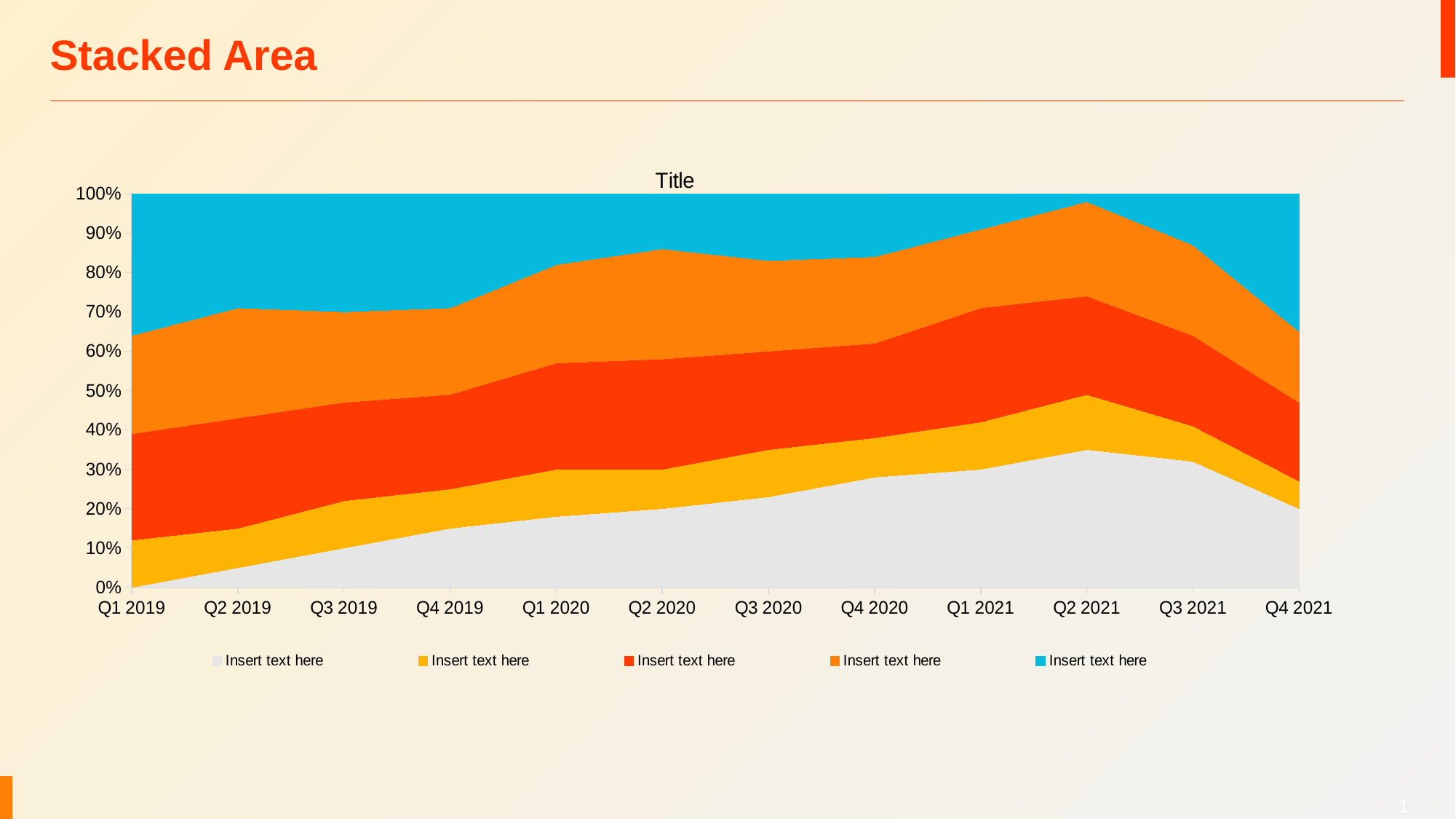
How many series does the legend list? 5 What kind of chart is shown on the slide? Stacked area chart What is the first category on the x axis? Q1 2019 Is the bottom (grey) series larger at Q4 2020 or at Q3 2019? Q4 2020 In which quarter does the bottom (grey) series reach its highest value? Q2 2021 How many quarters are shown along the x axis? 12 Is the value of the bottom (grey) series at Q1 2019 greater or less than 10%? less Is the value of the bottom (grey) series at Q2 2021 greater or less than 30%? greater Is the value of the top (blue) series at Q4 2021 greater or less than 30%? greater What is the title shown above the chart? Title In which quarter is the top (blue) series at its smallest? Q2 2021